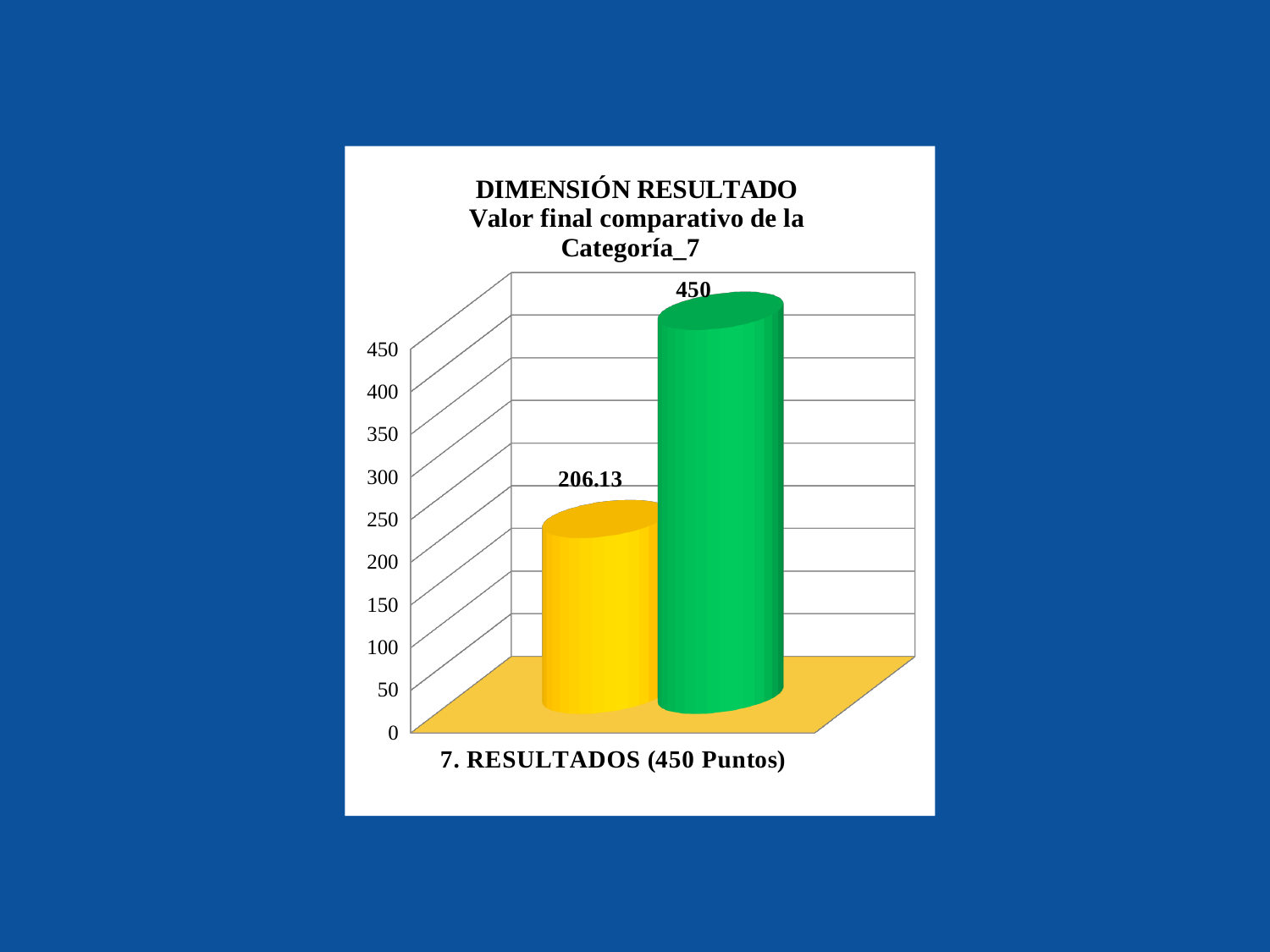
What is the category label shown on the x axis? 7. RESULTADOS (450 Puntos) What is the difference between the green bar's value and the yellow bar's value? 243.87 Is the value of the green bar greater or less than 400? greater Which bar has the lower value, the yellow one or the green one? the yellow bar Is the value of the yellow bar greater or less than 250? less What value is shown on the yellow bar? 206.13 What kind of chart is shown on the slide? bar chart What value is shown on the green bar? 450 What is the highest value shown on the vertical axis? 450 Which bar has the higher value, the yellow one or the green one? the green bar How many bars are plotted on the chart? 2